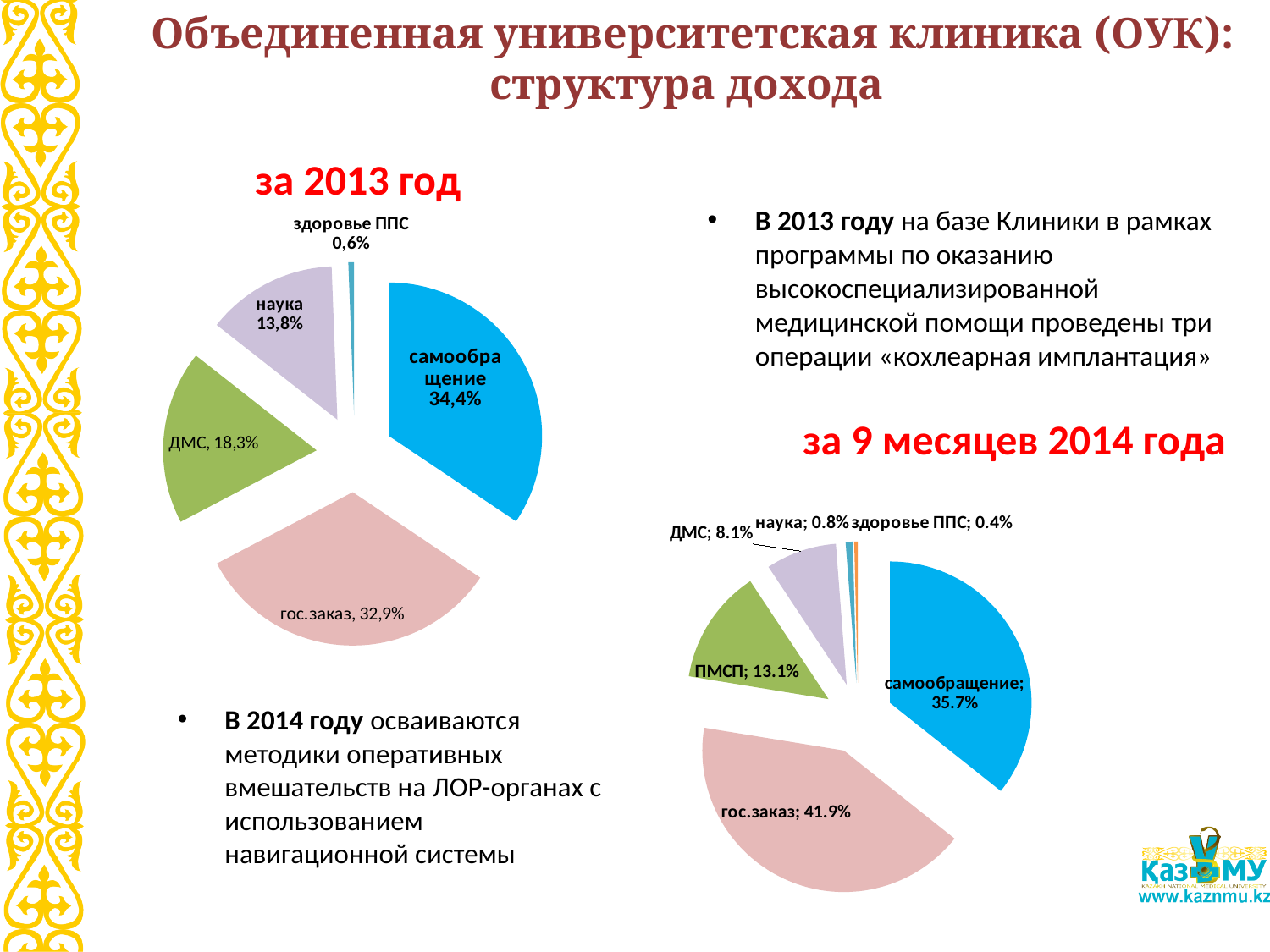
In the 'за 9 месяцев 2014 года' pie chart, which category has the largest share? гос.заказ In the 'за 9 месяцев 2014 года' pie chart, how many categories are shown? 6 In the 'за 9 месяцев 2014 года' pie chart, what is the value for гос.заказ? 41.9% What type of chart is used for 'за 2013 год'? Pie chart In the 'за 2013 год' pie chart, how many slices are there? 5 In the 'за 2013 год' pie chart, what is the value for гос.заказ? 32,9% In the 'за 9 месяцев 2014 года' pie chart, what share does ПМСП have? 13.1% In the 'за 2013 год' pie chart, which category has the largest share? самообращение In the 'за 2013 год' pie chart, which category has the smallest share? здоровье ППС In the 'за 2013 год' pie chart, what is the difference between ДМС and наука? 4,5% In the 'за 9 месяцев 2014 года' pie chart, which is larger, ДМС or наука? ДМС In the 'за 2013 год' pie chart, what share does самообращение have? 34,4%